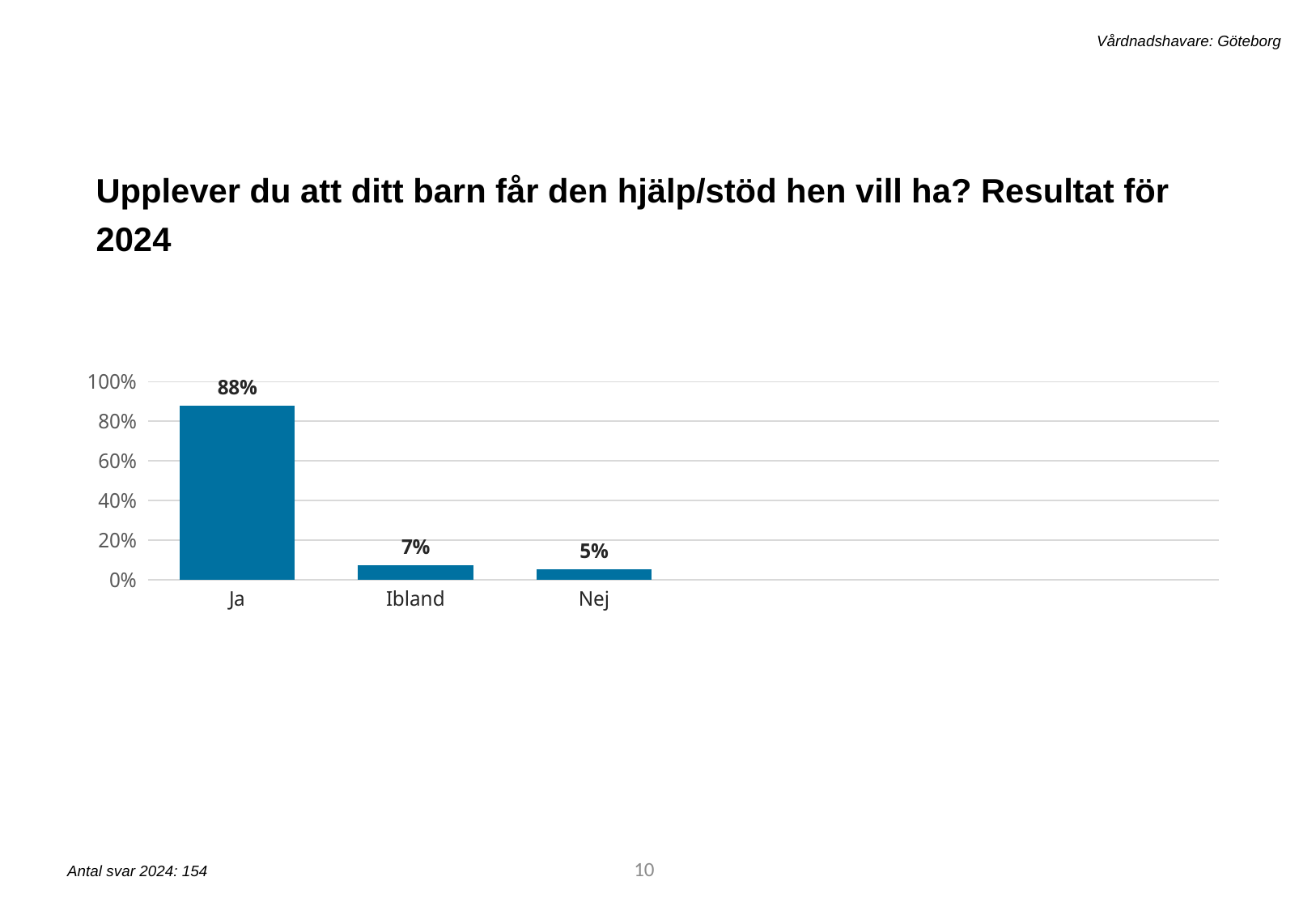
What is the value for Nej? 5% What is the difference between the values for Ja and Ibland? 81% Is the value for Ja greater or less than 80%? greater What is the difference between the values for Ibland and Nej? 2% What is the number of responses (Antal svar) stated for 2024? 154 What kind of chart is shown on the slide? bar chart Which category has the lowest value? Nej Which category has the highest value? Ja What is the value for Ibland? 7% What is the value for Ja? 88% Which is larger, the value for Ibland or the value for Nej? Ibland How many categories are shown on the x axis? 3